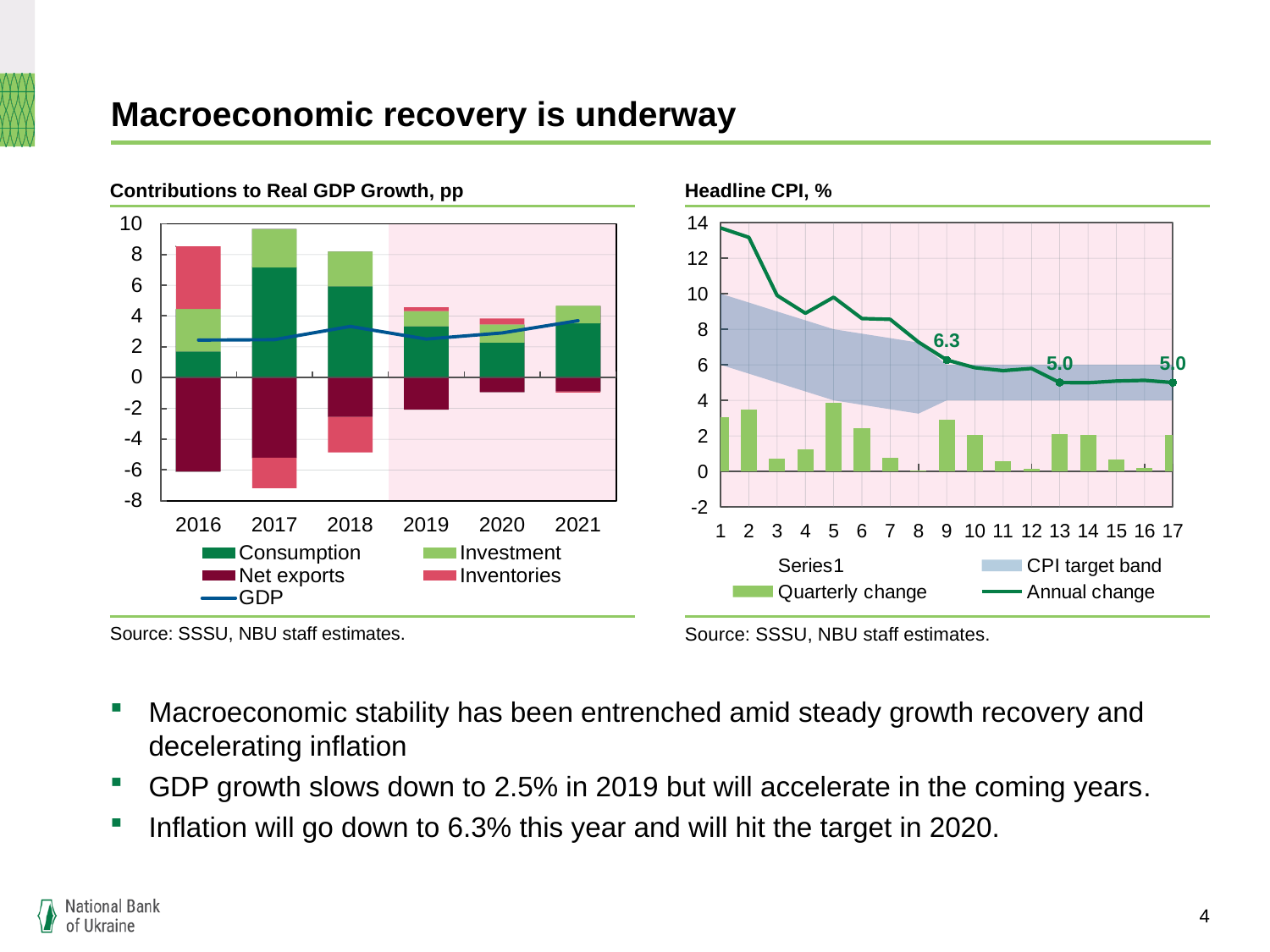
On the Contributions to Real GDP Growth chart, how many years are shown on the x axis? 6 On the Headline CPI chart, what is the labelled value of the annual change at point 9? 6.3 On the Headline CPI chart, how many points are shown on the x axis? 17 On the Headline CPI chart, is the annual change at point 1 greater or less than 12? greater On the Headline CPI chart, does the annual change line generally rise or fall from point 1 to point 17? Fall On the Contributions to Real GDP Growth chart, is the GDP line value for 2019 greater or less than 4? less On the Headline CPI chart, what is the difference between the labelled annual change at point 9 and at point 13? 1.3 On the Contributions to Real GDP Growth chart, how many series does the legend list? 5 On the Headline CPI chart, what is the labelled value of the annual change at point 13? 5.0 On the Headline CPI chart, how many entries does the legend list? 4 On the Headline CPI chart, what is the labelled value of the annual change at point 17? 5.0 On the Headline CPI chart, which is larger: the labelled annual change at point 9 or at point 13? Point 9